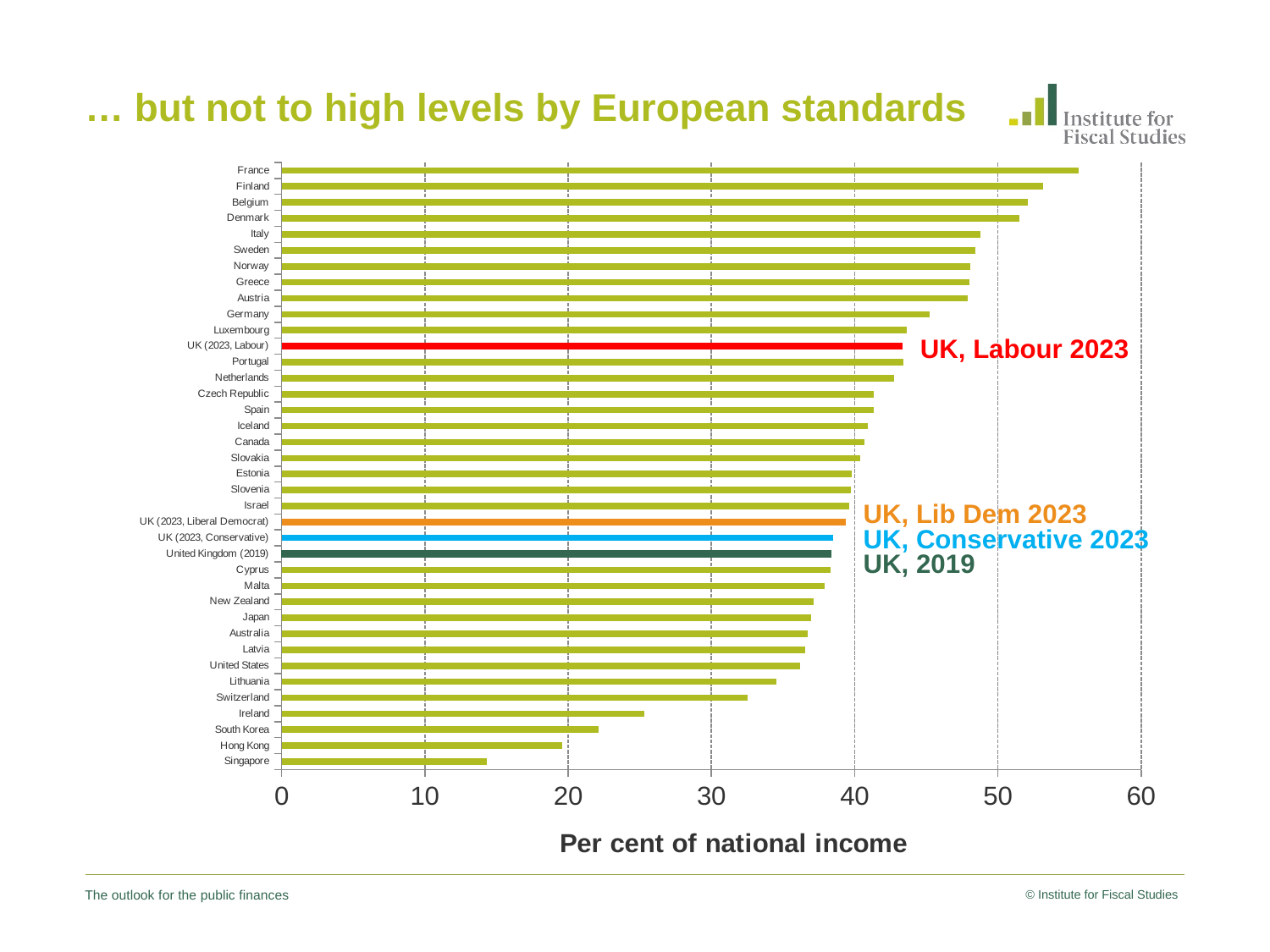
Is the value for UK (2023, Labour) greater or less than 40? greater Is the value for Ireland greater or less than 30? less Which has the larger value, UK (2023, Labour) or United Kingdom (2019)? UK (2023, Labour) Which has the larger value, Germany or Japan? Germany How many bars (categories) are plotted in the chart? 38 What kind of chart is shown on the slide? bar chart What is the label on the horizontal axis of the chart? Per cent of national income Is the value for Singapore greater or less than 20? less Which country or category has the highest value in the chart? France Which country or category has the lowest value in the chart? Singapore